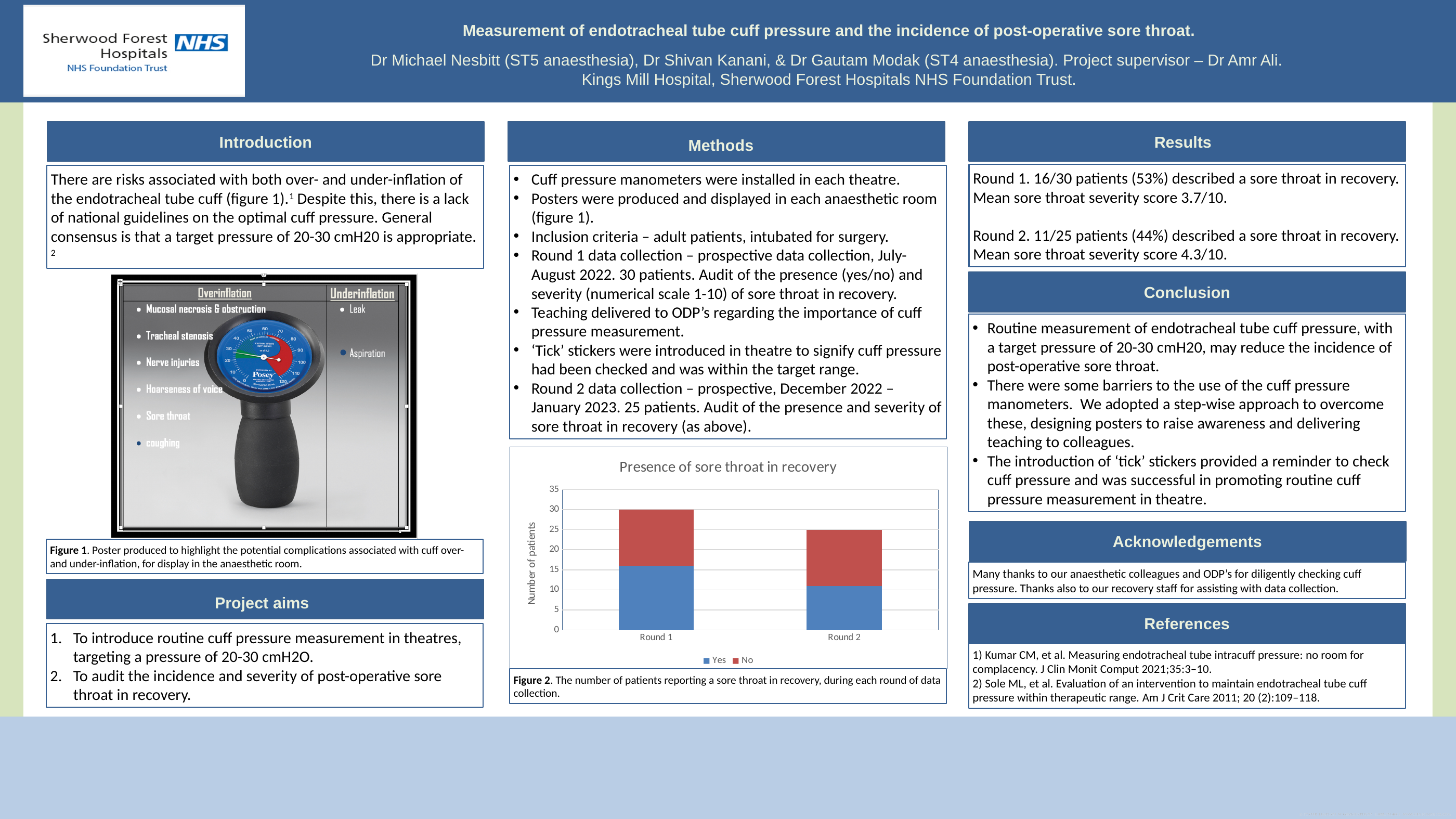
What type of chart is shown in Figure 2? bar chart Which round has the larger 'Yes' segment, Round 1 or Round 2? Round 1 How many series does the legend of the chart list? 2 What is the title of the chart in Figure 2? Presence of sore throat in recovery Does the total number of patients rise or fall from Round 1 to Round 2? fall Is the 'Yes' value for Round 1 greater or less than 20? less What is the total height of the stacked bar for Round 2? 25 What is the label on the y axis of the chart? Number of patients Which round has the taller stacked bar overall, Round 1 or Round 2? Round 1 How many categories are shown on the x axis of the chart? 2 Is the 'Yes' value for Round 2 greater or less than 15? less What is the total height of the stacked bar for Round 1? 30